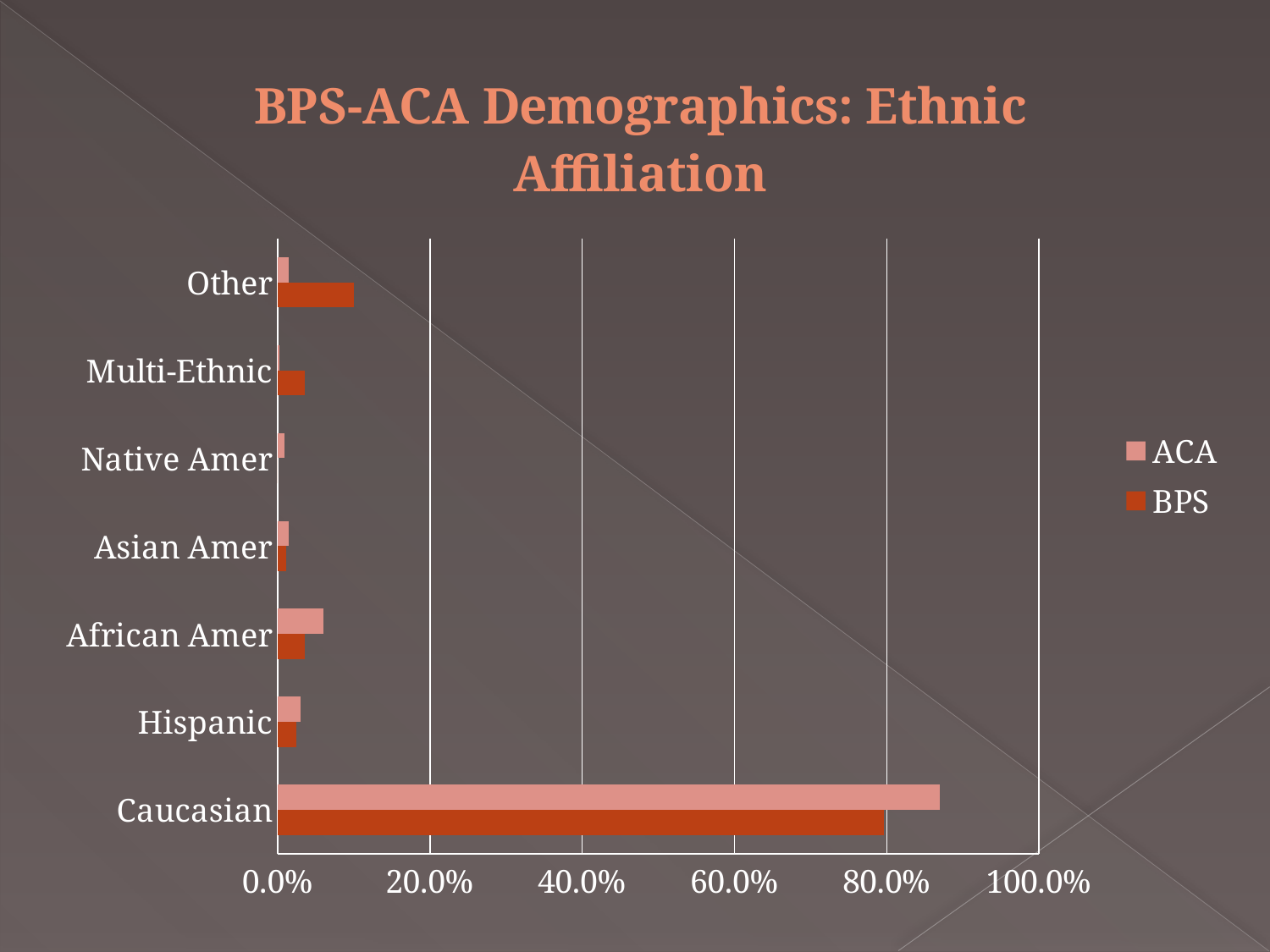
How many ethnic categories are shown on the chart? 7 How many series does the legend list? 2 For African Amer, which series has the larger value, ACA or BPS? ACA What is the title of the chart? BPS-ACA Demographics: Ethnic Affiliation Which category has the highest ACA value? Caucasian Is the BPS value for Other greater or less than 20.0%? less Is the ACA value for Caucasian greater or less than 80.0%? greater Which category has the highest BPS value? Caucasian For Caucasian, which series has the larger value, ACA or BPS? ACA What type of chart is shown on the slide? bar chart For Other, which series has the larger value, ACA or BPS? BPS Which category has the lowest BPS value? Native Amer